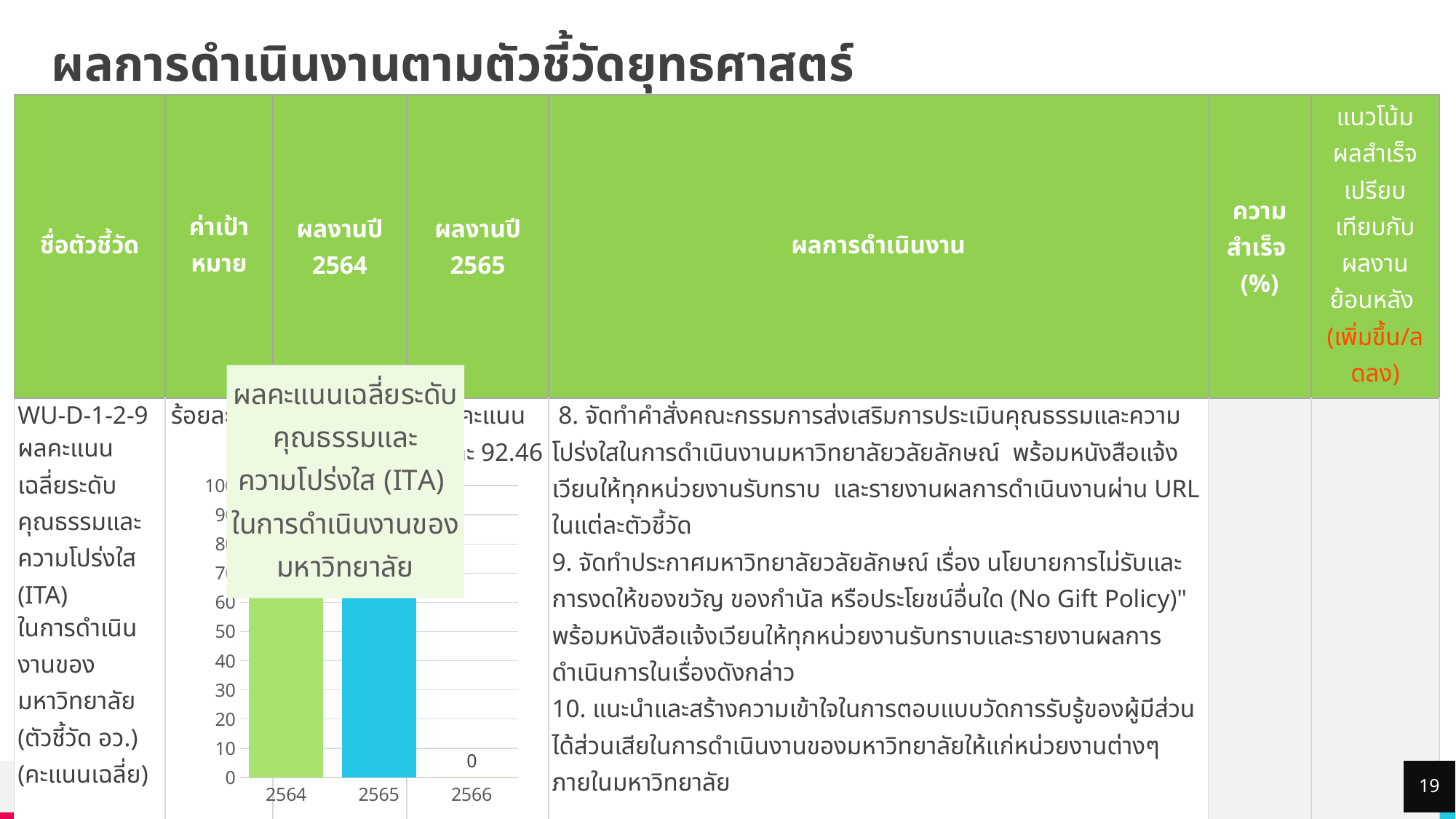
Between 2565 and 2566, does the value rise or fall? fall What is the value shown for 2566 in the chart? 0 What colour is the bar for 2565 in the chart? blue What kind of chart is shown on the slide? bar chart Is the value for 2565 greater or less than 50? greater Which is larger, the value for 2565 or the value for 2566? 2565 How many categories (years) are shown on the x axis of the chart? 3 Is the value for 2564 greater or less than 50? greater Which year has the lowest value in the chart? 2566 What is the highest tick value shown on the chart's y axis? 100